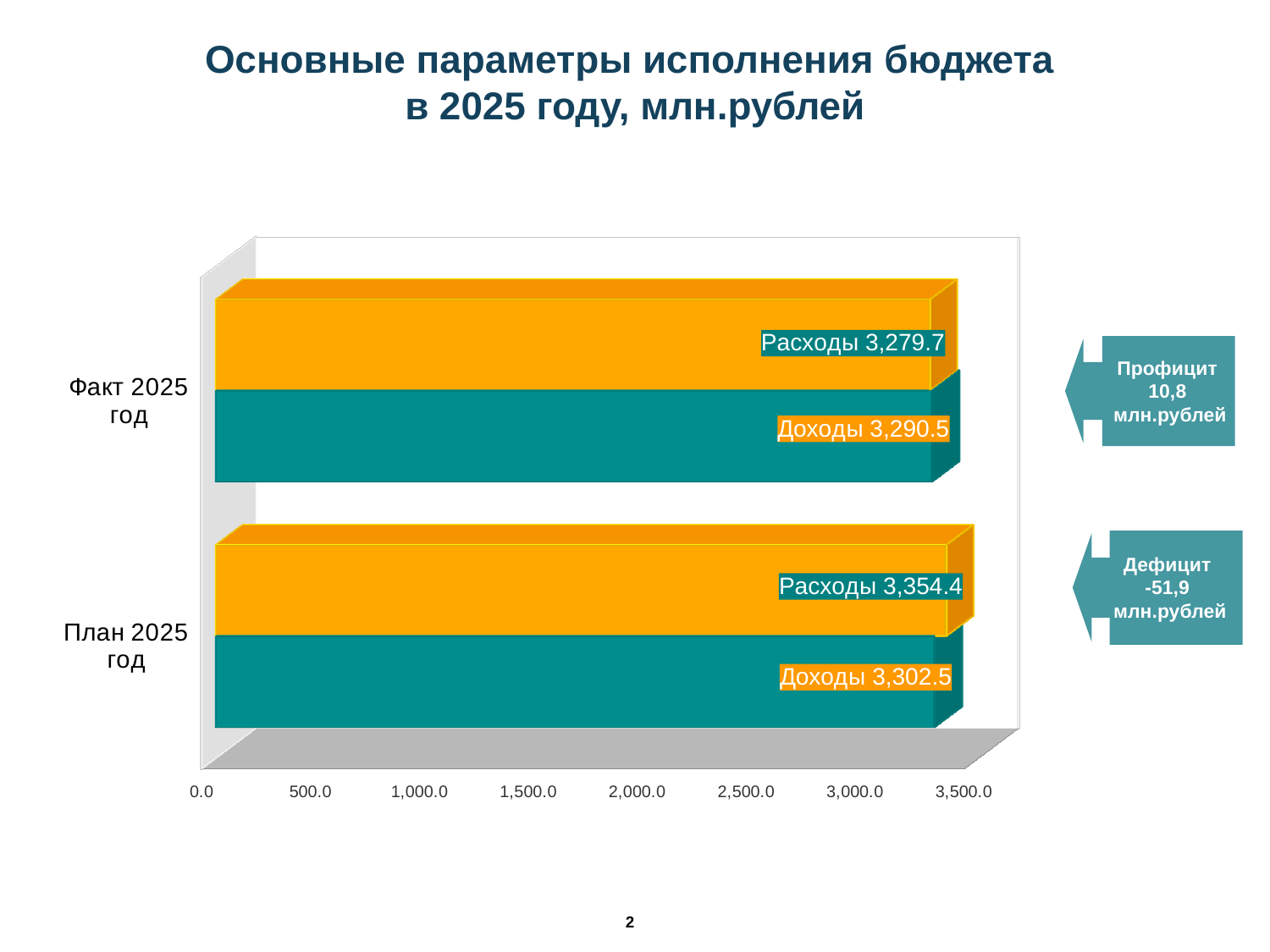
What is the value of Доходы for План 2025 год? 3,302.5 What is the difference between Расходы and Доходы for План 2025 год? 51.9 What is the difference between Доходы and Расходы for Факт 2025 год? 10.8 What is the value of Доходы for Факт 2025 год? 3,290.5 What is the value of Расходы for Факт 2025 год? 3,279.7 Which bar has the lowest value on the chart? Расходы, Факт 2025 год (3,279.7) What type of chart is shown on the slide? Bar chart How many categories are shown on the chart? 2 Which is larger for План 2025 год: Расходы or Доходы? Расходы Which bar has the highest value on the chart? Расходы, План 2025 год (3,354.4) Is the value of Доходы for Факт 2025 год greater or less than 3,000.0? greater What is the value of Расходы for План 2025 год? 3,354.4